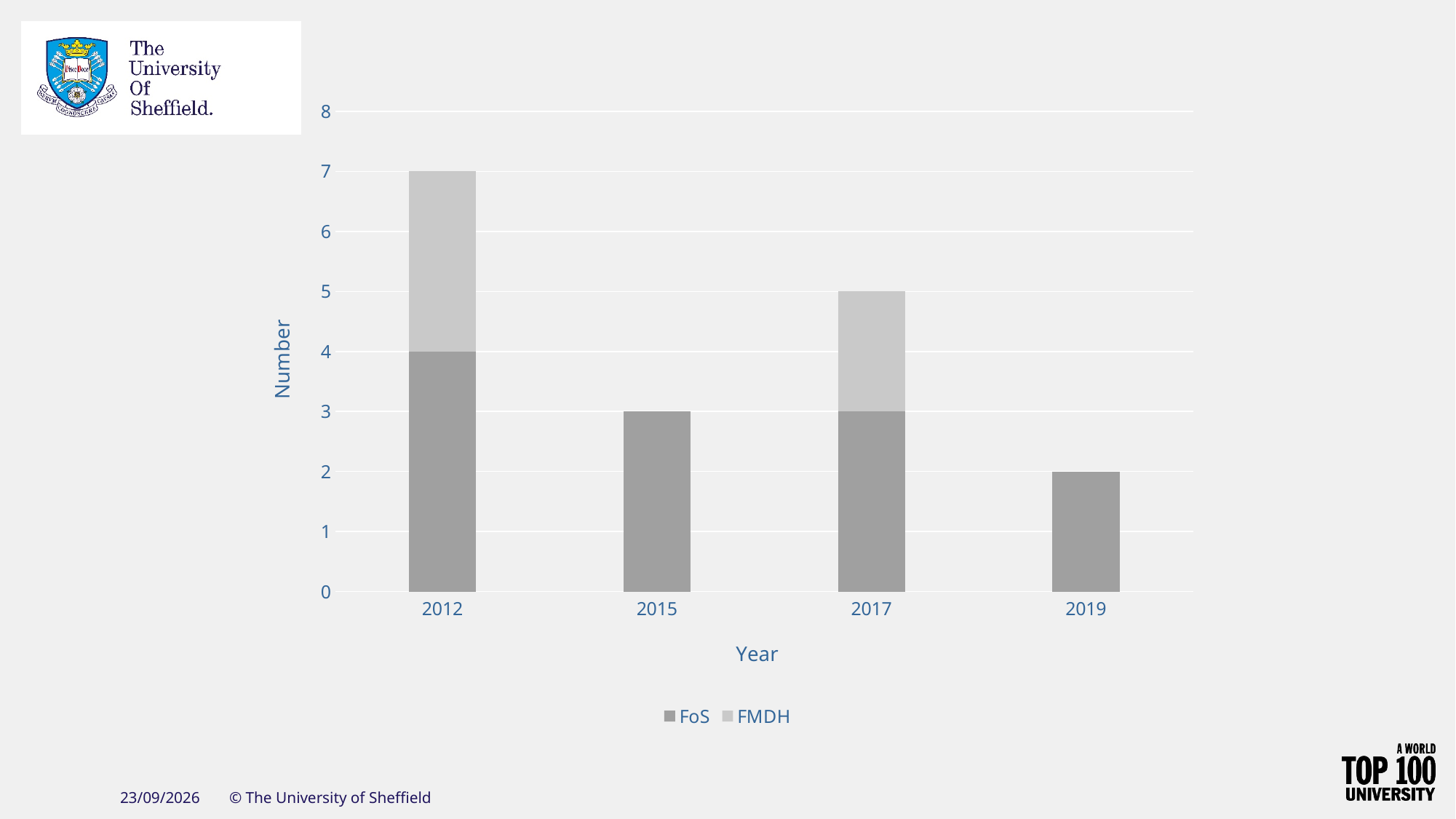
What is the label on the y axis of the chart? Number What is the FoS value for 2019? 2 What is the difference between the FoS values for 2012 and 2019? 2 How many years are shown on the x axis of the chart? 4 Which year has the shortest stacked bar? 2019 What is the total height of the stacked bar for 2012? 7 Which year has the tallest stacked bar? 2012 What is the total height of the stacked bar for 2017? 5 Which is larger, the FMDH value for 2012 or the FMDH value for 2017? 2012 How many series does the chart's legend list? 2 What is the FoS value for 2012? 4 What kind of chart is shown on the slide? Stacked bar chart